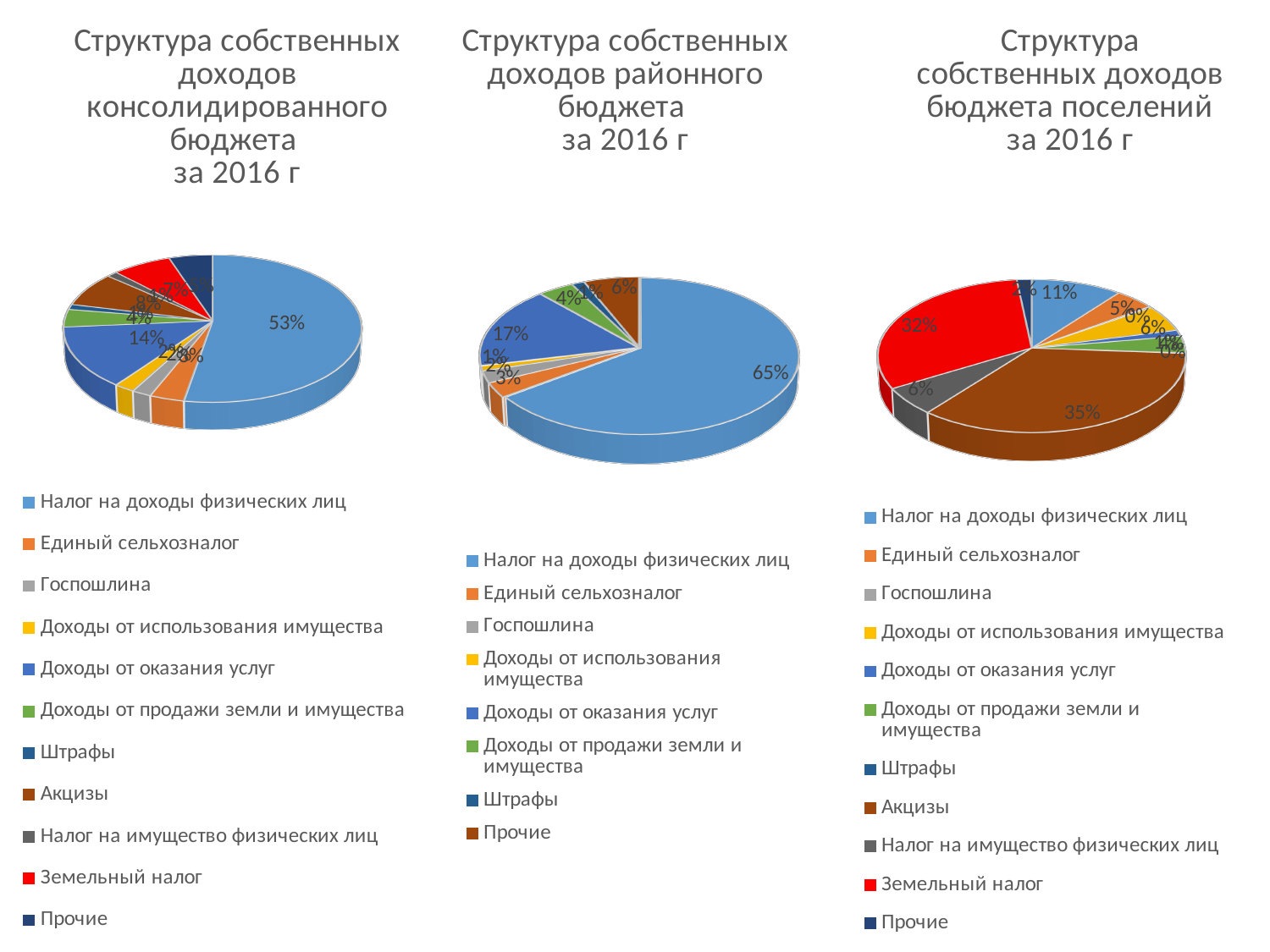
In the left chart (Структура собственных доходов консолидированного бюджета за 2016 г), what share does Налог на доходы физических лиц have? 53% How many entries does the legend of the middle chart (районного бюджета) list? 8 In the middle chart (районного бюджета), what share does Доходы от оказания услуг have? 17% In the middle chart (районного бюджета), what is the difference in percentage points between Налог на доходы физических лиц and Доходы от оказания услуг? 48 In the right chart (Структура собственных доходов бюджета поселений за 2016 г), which category has the largest slice? Акцизы What kind of chart is used on this slide for the structure of own revenues? Pie chart In the right chart (бюджета поселений), which is larger: Акцизы or Земельный налог? Акцизы In the left chart (консолидированного бюджета), which category has the largest slice? Налог на доходы физических лиц How many entries does the legend of the left chart (консолидированного бюджета) list? 11 In the left chart (консолидированного бюджета), what share does Доходы от оказания услуг have? 14% How many charts are shown on the slide? 3